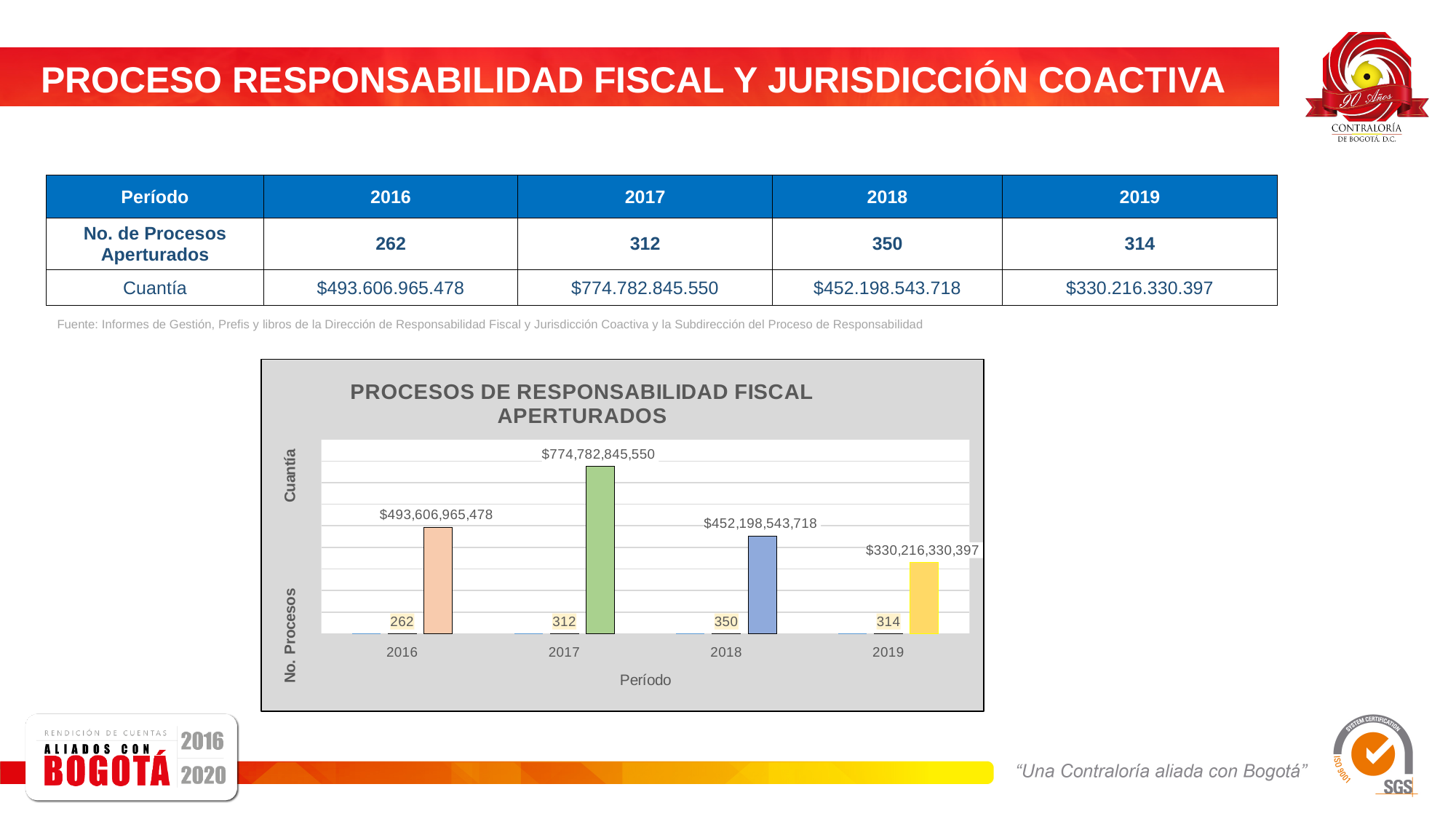
Which period has the lowest Cuantía in the chart? 2019 Which is larger, the Cuantía for 2016 or the Cuantía for 2018? 2016 What is the Cuantía value shown for 2017 in the chart? $774,782,845,550 What is the difference between the Cuantía for 2017 and the Cuantía for 2016? $281,175,880,072 Which period has the lowest number of processes (No. Procesos) in the chart? 2016 What is the difference between the number of processes in 2018 and in 2016? 88 How many processes (No. Procesos) are labelled for 2018 in the chart? 350 What is the Cuantía value shown for 2019 in the chart? $330,216,330,397 How many periods are shown on the x axis of the chart? 4 What kind of chart is shown on the slide? Bar chart How many processes (No. Procesos) are labelled for 2016 in the chart? 262 Which period has the highest Cuantía in the chart? 2017